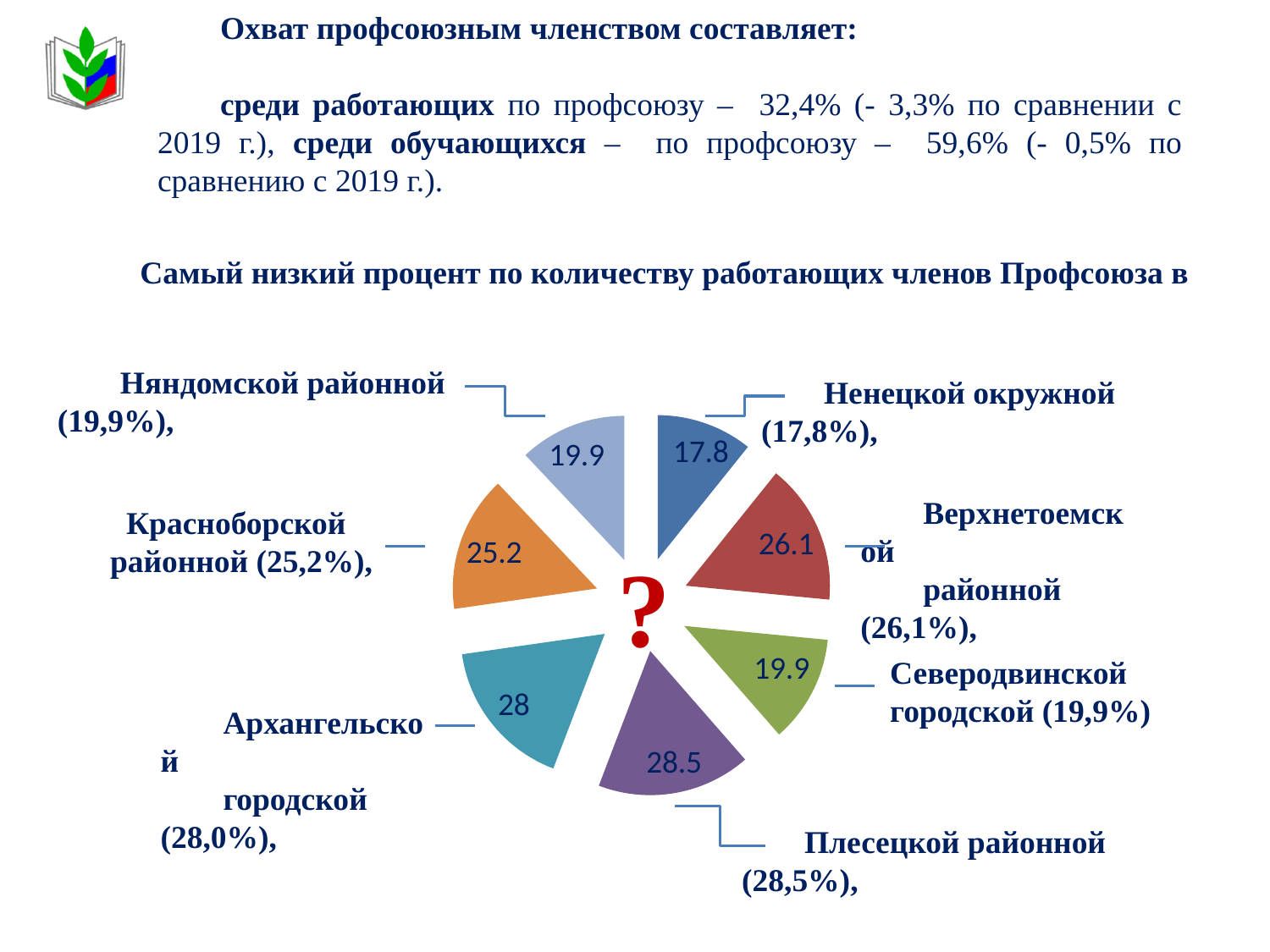
What is the difference between the values for Плесецкой районной and Ненецкой окружной? 10.7 What value is shown for the Красноборской районной slice? 25.2 What value is shown for the Верхнетоемской районной slice? 26.1 Which two organisations share the same value of 19.9 in the pie chart? Няндомской районной and Северодвинской городской Which organisation has the lowest value in the pie chart? Ненецкой окружной What kind of chart is shown on the slide? pie chart Which organisation has the highest value in the pie chart? Плесецкой районной Which is larger, the value for Архангельской городской or the value for Красноборской районной? Архангельской городской What value is shown for the Плесецкой районной slice? 28.5 How many slices does the pie chart have? 7 What symbol is printed in the centre of the pie chart? ? What value is shown for the Ненецкой окружной slice? 17.8